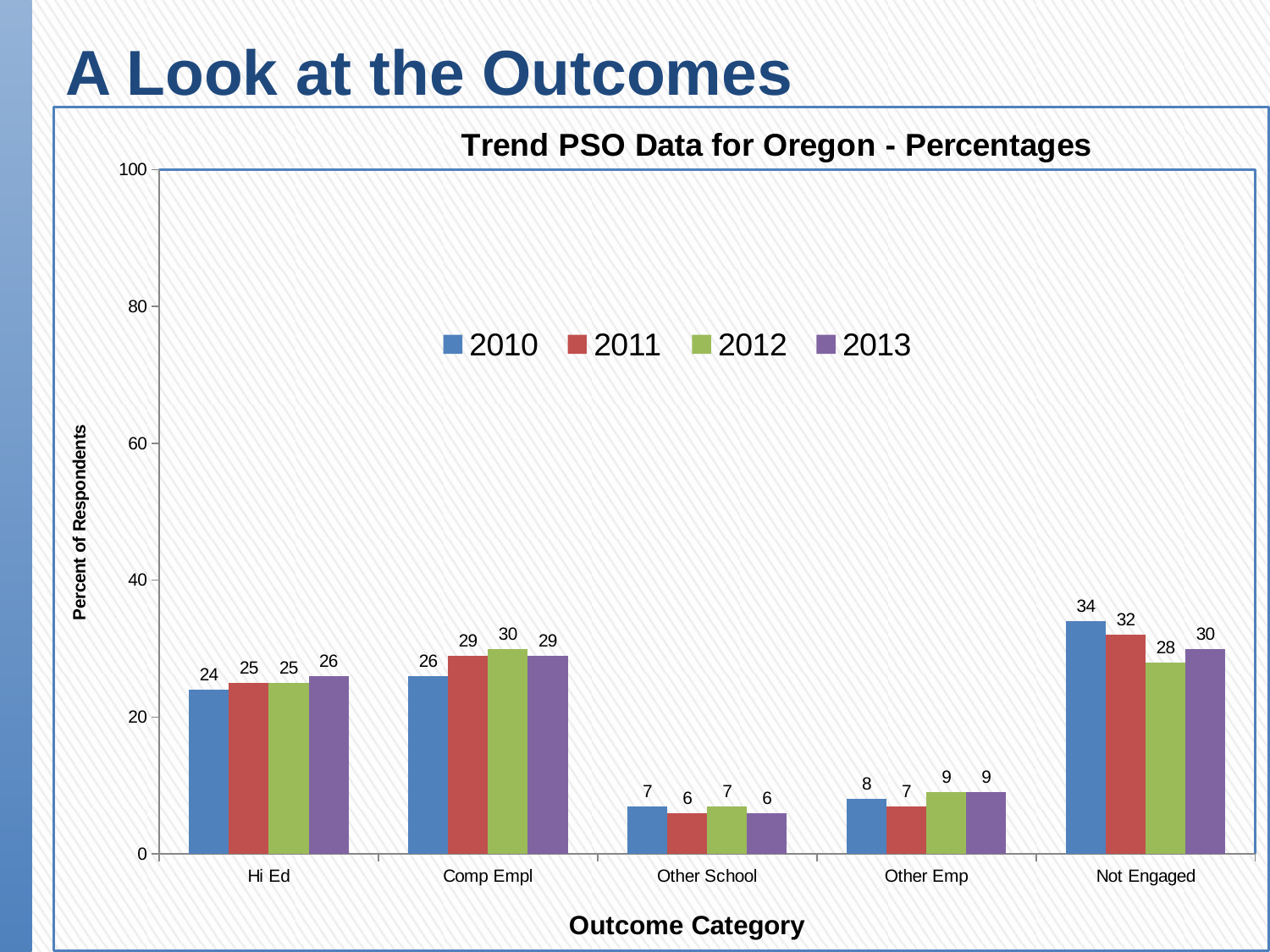
Which is larger for Hi Ed: the 2010 value or the 2013 value? 2013 Which outcome category has the lowest value in 2011? Other School What is the value for Comp Empl in 2012? 30 Which outcome category has the highest value in 2013? Not Engaged What kind of chart is shown on the slide? bar chart Is the value for Comp Empl in 2011 greater or less than 20? greater How many outcome categories are shown on the x axis? 5 What is the title of the chart? Trend PSO Data for Oregon - Percentages What is the value for Other Emp in 2011? 7 What is the value for Not Engaged in 2010? 34 How many series does the legend list? 4 What is the difference between the 2010 and 2012 values for Not Engaged? 6